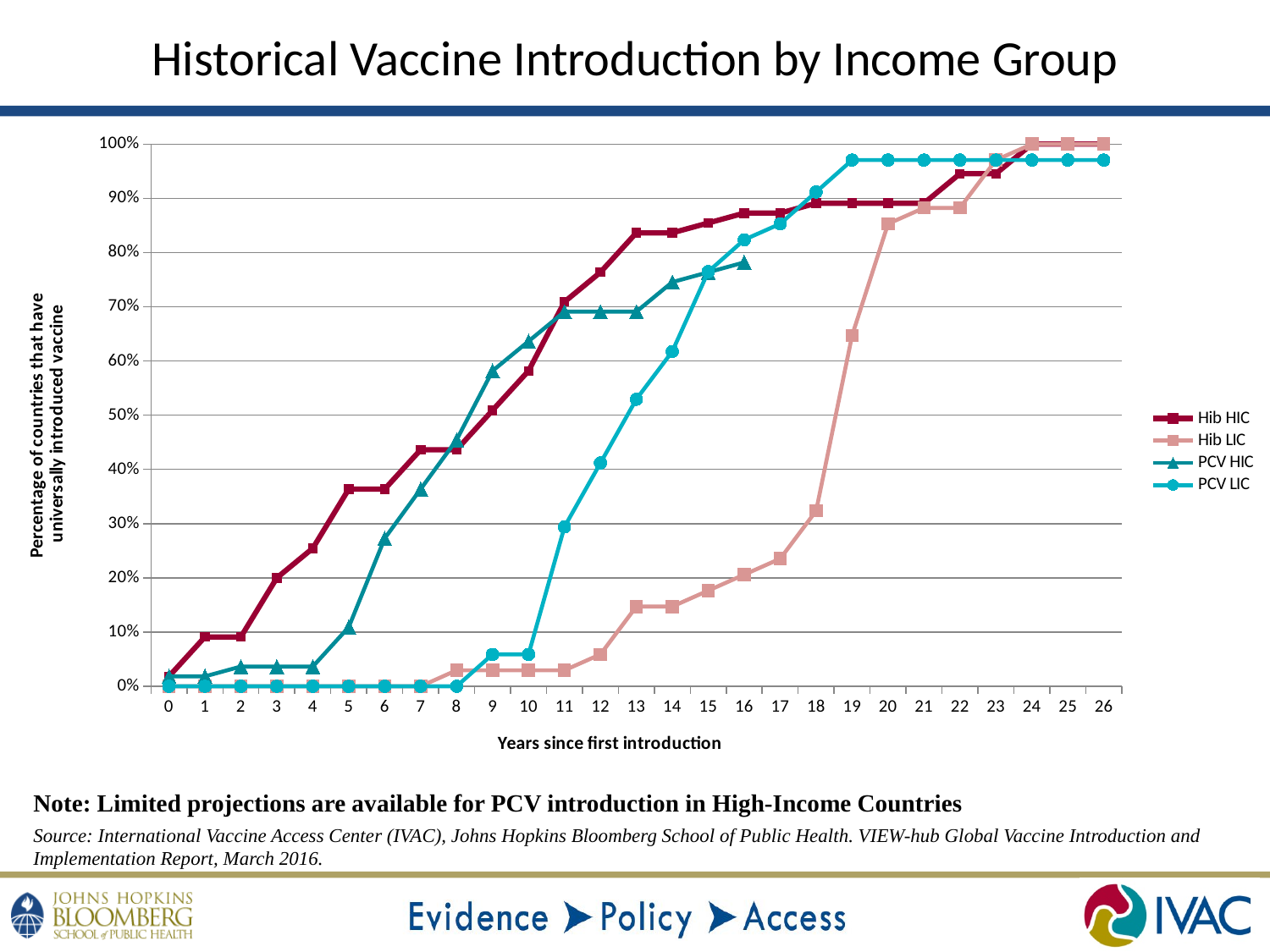
Do the values of the Hib LIC series rise or fall as years since first introduction increase? rise How many series does the legend list? 4 What kind of chart is shown on the slide? line chart At year 14, which is higher: PCV HIC or PCV LIC? PCV HIC What is the value of the PCV LIC series at year 5? 0% At year 10, which series has the lowest value? Hib LIC Is the value for PCV HIC at year 16 greater or less than 80%? less Is the value for Hib LIC at year 19 greater or less than 60%? greater What is the title of the x axis? Years since first introduction Is the value for Hib HIC at year 13 greater or less than 80%? greater At year 19, which series has the highest value? PCV LIC What value does the Hib LIC series reach at year 24? 100%